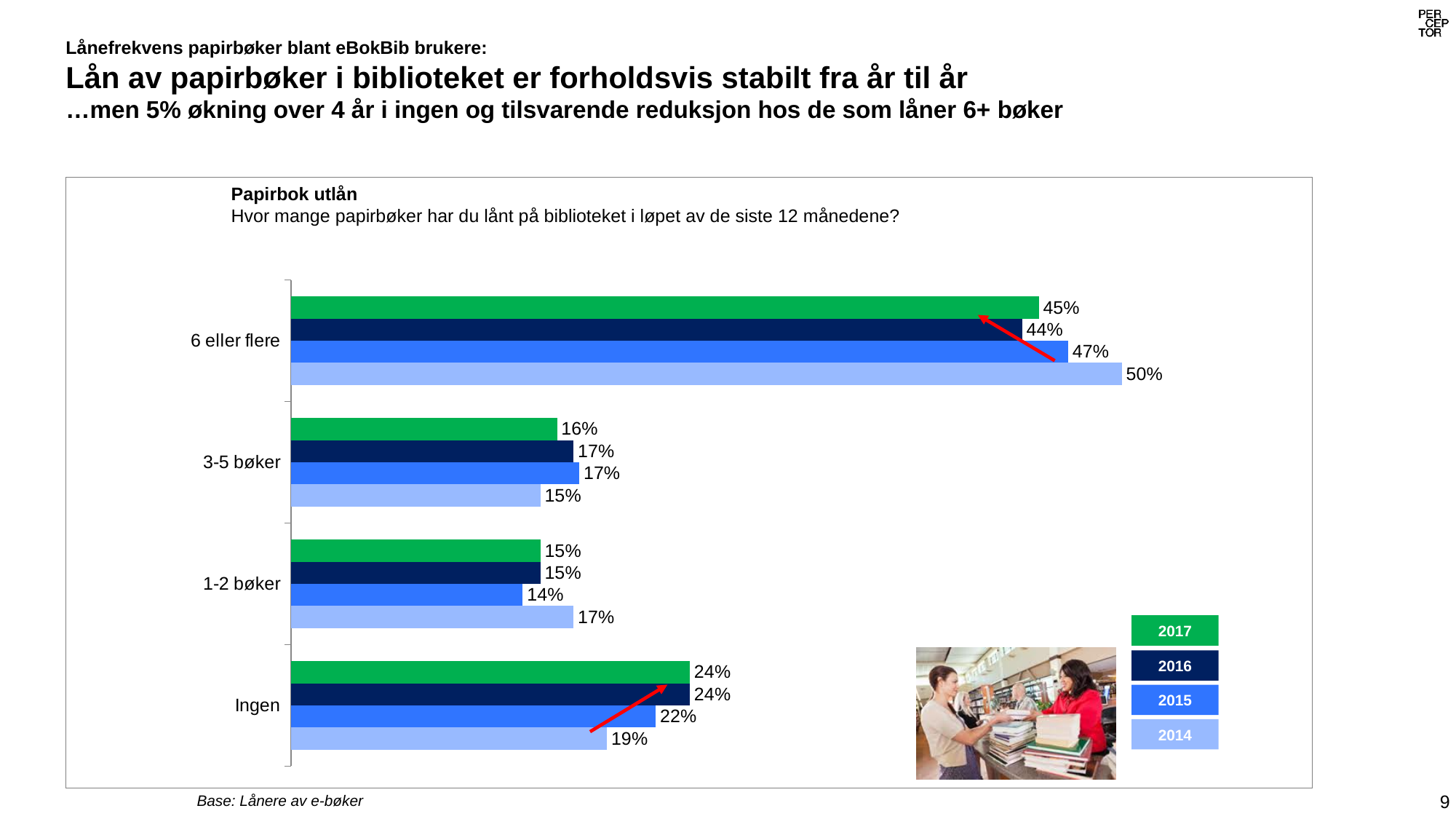
Which year is shown in green in the legend? 2017 What is the difference between the 2014 and 2017 values for '6 eller flere'? 5% What is the value for '6 eller flere' in 2014? 50% Which is larger for 'Ingen': the 2014 value or the 2015 value? 2015 How many series does the legend list? 4 How many categories are shown on the chart? 4 Which category has the highest value in 2017? 6 eller flere Which category has the lowest value in 2014? 3-5 bøker What is the value for '3-5 bøker' in 2016? 17% What kind of chart is shown on the slide? bar chart What is the value for '1-2 bøker' in 2015? 14% What is the value for 'Ingen' in 2017? 24%